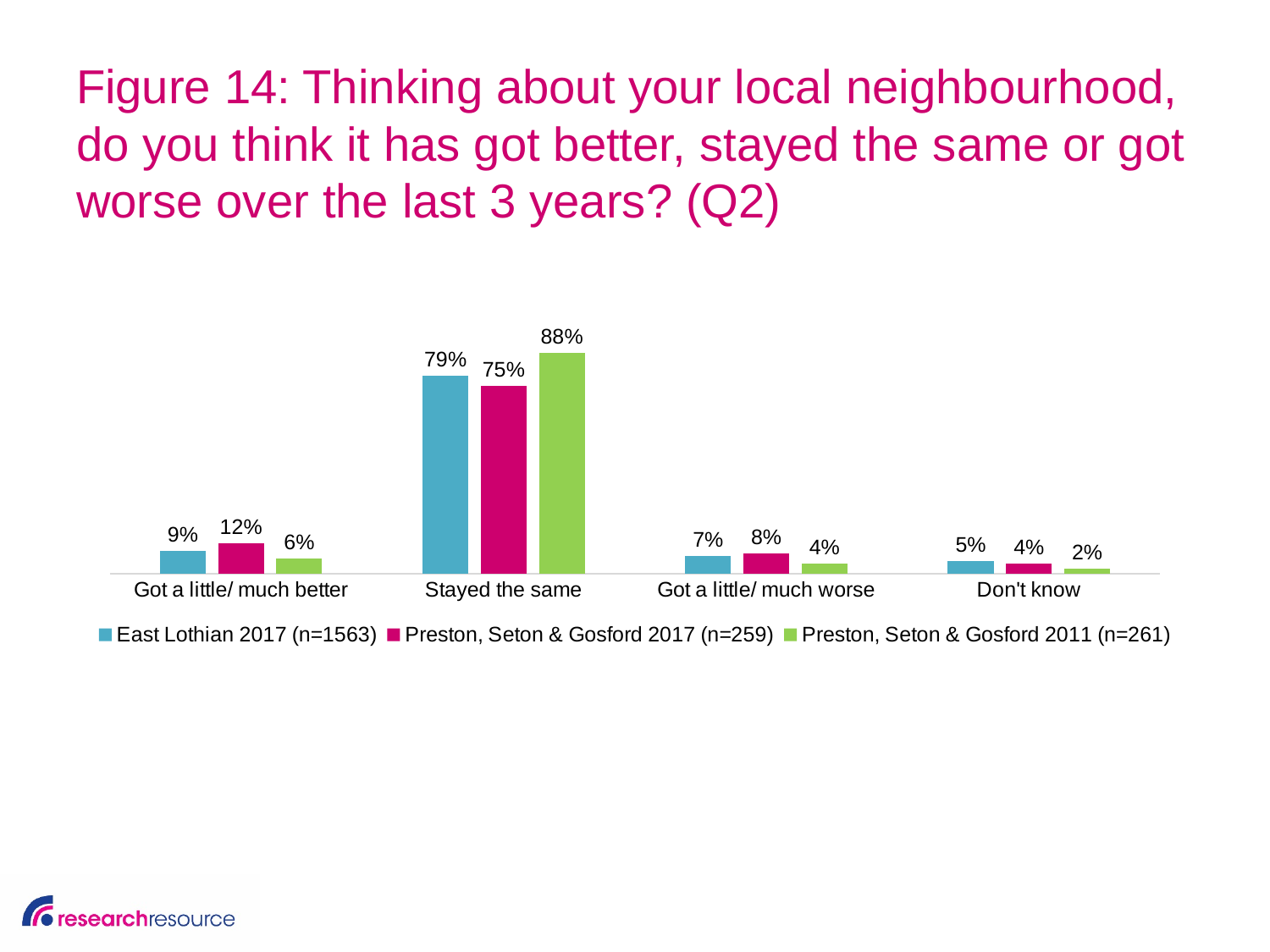
Which category has the highest value for the Preston, Seton & Gosford 2011 series? Stayed the same What percentage of Preston, Seton & Gosford 2017 respondents answered 'Don't know'? 4% What percentage of East Lothian 2017 respondents said their neighbourhood stayed the same? 79% How many series does the legend list? 3 What is the difference between the Preston, Seton & Gosford 2011 and Preston, Seton & Gosford 2017 values for 'Stayed the same'? 13% Which category has the lowest value for the East Lothian 2017 series? Don't know In the 'Got a little/ much better' category, which series has the larger value: East Lothian 2017 or Preston, Seton & Gosford 2017? Preston, Seton & Gosford 2017 How many response categories are shown on the x axis? 4 What is the sample size (n) for the East Lothian 2017 series shown in the legend? 1563 What kind of chart is shown on the slide? Bar chart What is the value for Preston, Seton & Gosford 2011 in the 'Got a little/ much better' category? 6% What is the difference between the East Lothian 2017 and Preston, Seton & Gosford 2011 values for 'Got a little/ much worse'? 3%